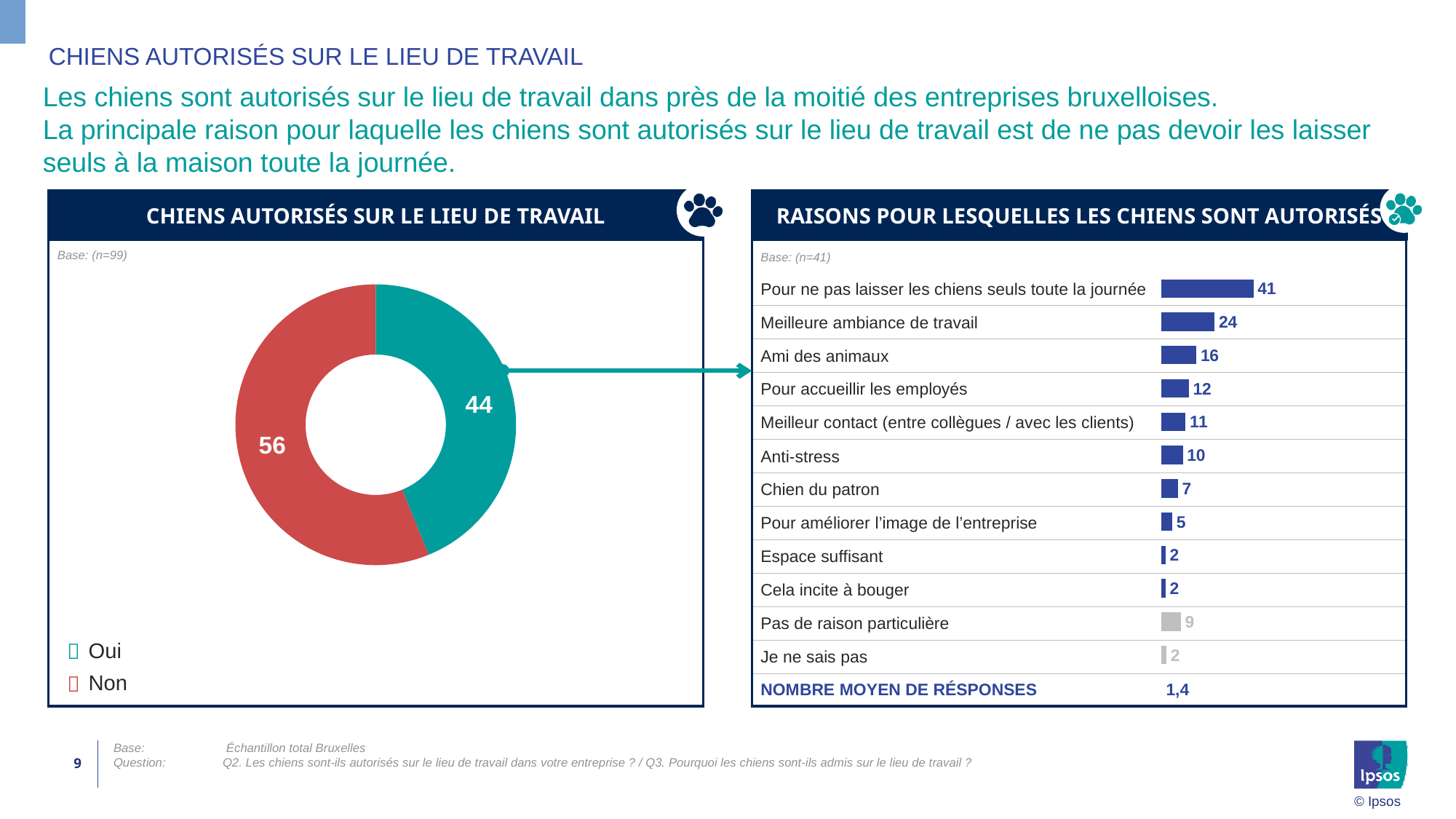
How many categories are listed in the chart titled 'RAISONS POUR LESQUELLES LES CHIENS SONT AUTORISÉS'? 12 In the chart titled 'RAISONS POUR LESQUELLES LES CHIENS SONT AUTORISÉS', what is the value for 'Meilleure ambiance de travail'? 24 In the chart titled 'CHIENS AUTORISÉS SUR LE LIEU DE TRAVAIL', what is the difference between 'Non' and 'Oui'? 12 In the chart titled 'CHIENS AUTORISÉS SUR LE LIEU DE TRAVAIL', what is the value for 'Non'? 56 In the chart titled 'RAISONS POUR LESQUELLES LES CHIENS SONT AUTORISÉS', what is the value for 'Anti-stress'? 10 In the chart titled 'RAISONS POUR LESQUELLES LES CHIENS SONT AUTORISÉS', which is larger, 'Pour accueillir les employés' or 'Chien du patron'? Pour accueillir les employés What kind of chart is the one titled 'CHIENS AUTORISÉS SUR LE LIEU DE TRAVAIL'? Donut (pie) chart What kind of chart is the one titled 'RAISONS POUR LESQUELLES LES CHIENS SONT AUTORISÉS'? Bar chart In the chart titled 'CHIENS AUTORISÉS SUR LE LIEU DE TRAVAIL', which category is larger, 'Oui' or 'Non'? Non In the chart titled 'RAISONS POUR LESQUELLES LES CHIENS SONT AUTORISÉS', what is the difference between 'Pour ne pas laisser les chiens seuls toute la journée' and 'Ami des animaux'? 25 In the chart titled 'RAISONS POUR LESQUELLES LES CHIENS SONT AUTORISÉS', which reason has the highest value? Pour ne pas laisser les chiens seuls toute la journée In the chart titled 'CHIENS AUTORISÉS SUR LE LIEU DE TRAVAIL', what is the value for 'Oui'? 44